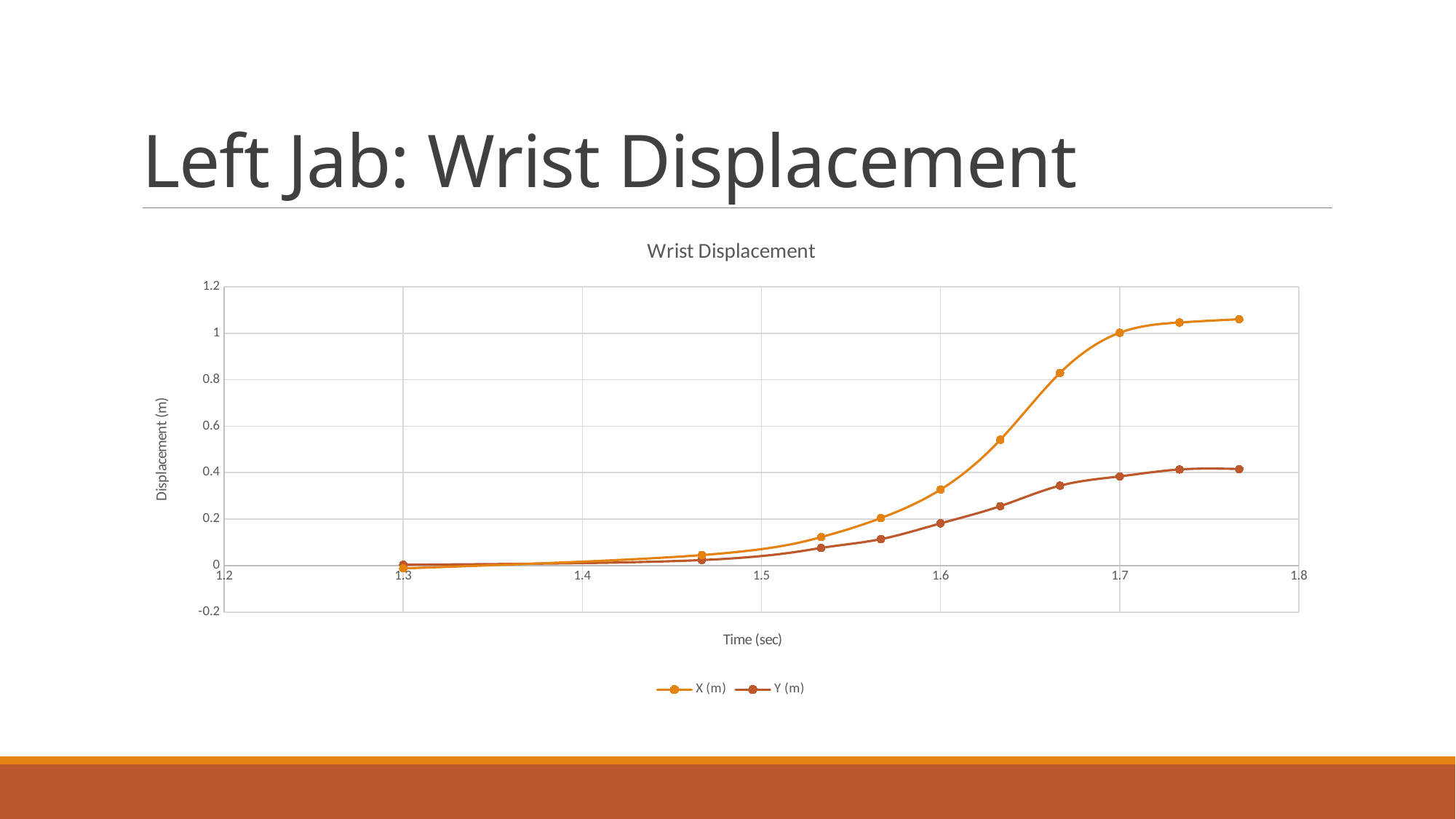
Do the X (m) values rise or fall as time increases along the x axis? rise At time 1.6, which series has the larger value, X (m) or Y (m)? X (m) Is the value for X (m) at time 1.6 greater or less than 0.2? greater What kind of chart is shown on the slide? line chart Is the value for X (m) at time 1.6 greater or less than 0.4? less Is the value for X (m) at time 1.667 greater or less than 0.6? greater What is the title of the chart? Wrist Displacement What is the label of the x axis? Time (sec) At time 1.7, which series has the larger value, X (m) or Y (m)? X (m) How many series does the legend list? 2 Do the Y (m) values rise or fall as time increases along the x axis? rise